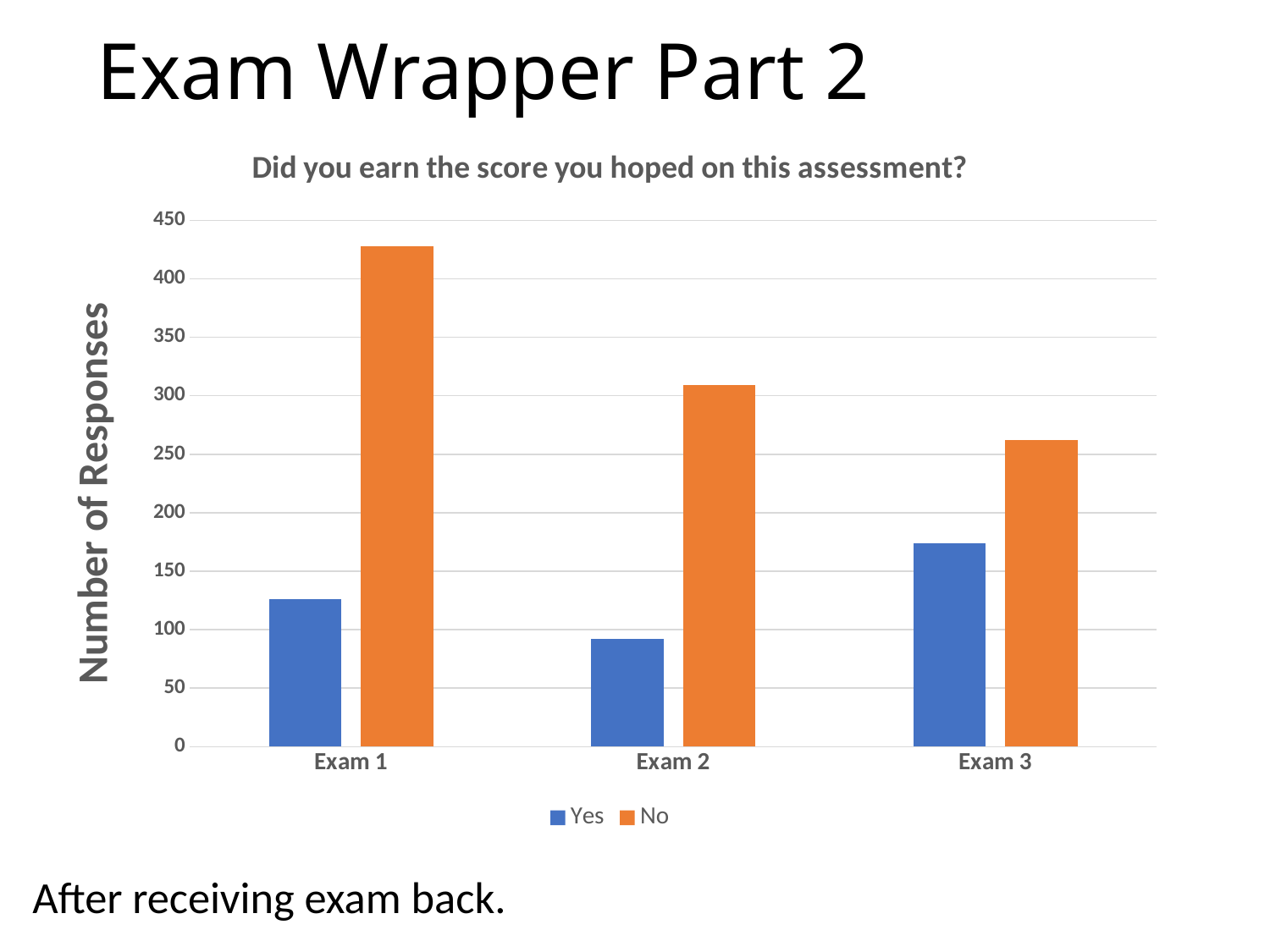
What kind of chart is shown on the slide? bar chart Which exam has the highest number of "No" responses? Exam 1 Which exam has the lowest number of "Yes" responses? Exam 2 How many series does the legend list? 2 Do the "No" responses rise or fall from Exam 1 to Exam 3? fall Which exam has the highest number of "Yes" responses? Exam 3 Is the value for "Yes" on Exam 2 greater or less than 100? less How many exam categories are shown on the x axis? 3 Is the value for "No" on Exam 1 greater or less than 400? greater Is the value for "Yes" on Exam 3 greater or less than 150? greater For Exam 2, which is larger: the "Yes" responses or the "No" responses? No What is the title of the chart? Did you earn the score you hoped on this assessment?